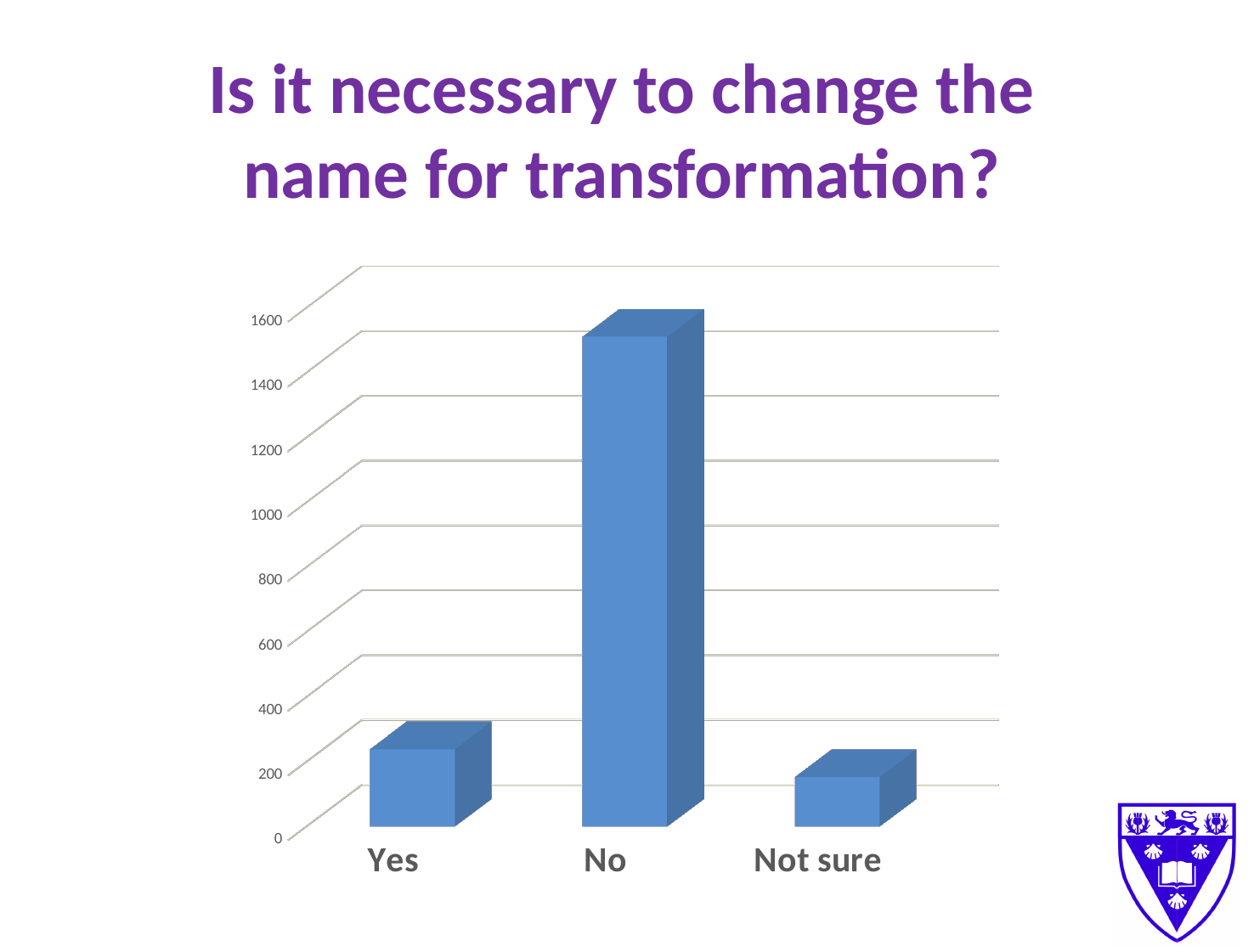
Which category has the highest value in the chart? No Is the value for Not sure greater or less than 400? less What is the highest tick value shown on the vertical axis of the chart? 1600 Which has a larger value, Yes or Not sure? Yes What kind of chart is shown on the slide? bar chart Which category has the lowest value in the chart? Not sure How many categories are shown on the x axis of the chart? 3 Is the value for Yes greater or less than 400? less What is the title of the chart on the slide? Is it necessary to change the name for transformation? Is the value for No greater or less than 1000? greater Which has a larger value, No or Yes? No